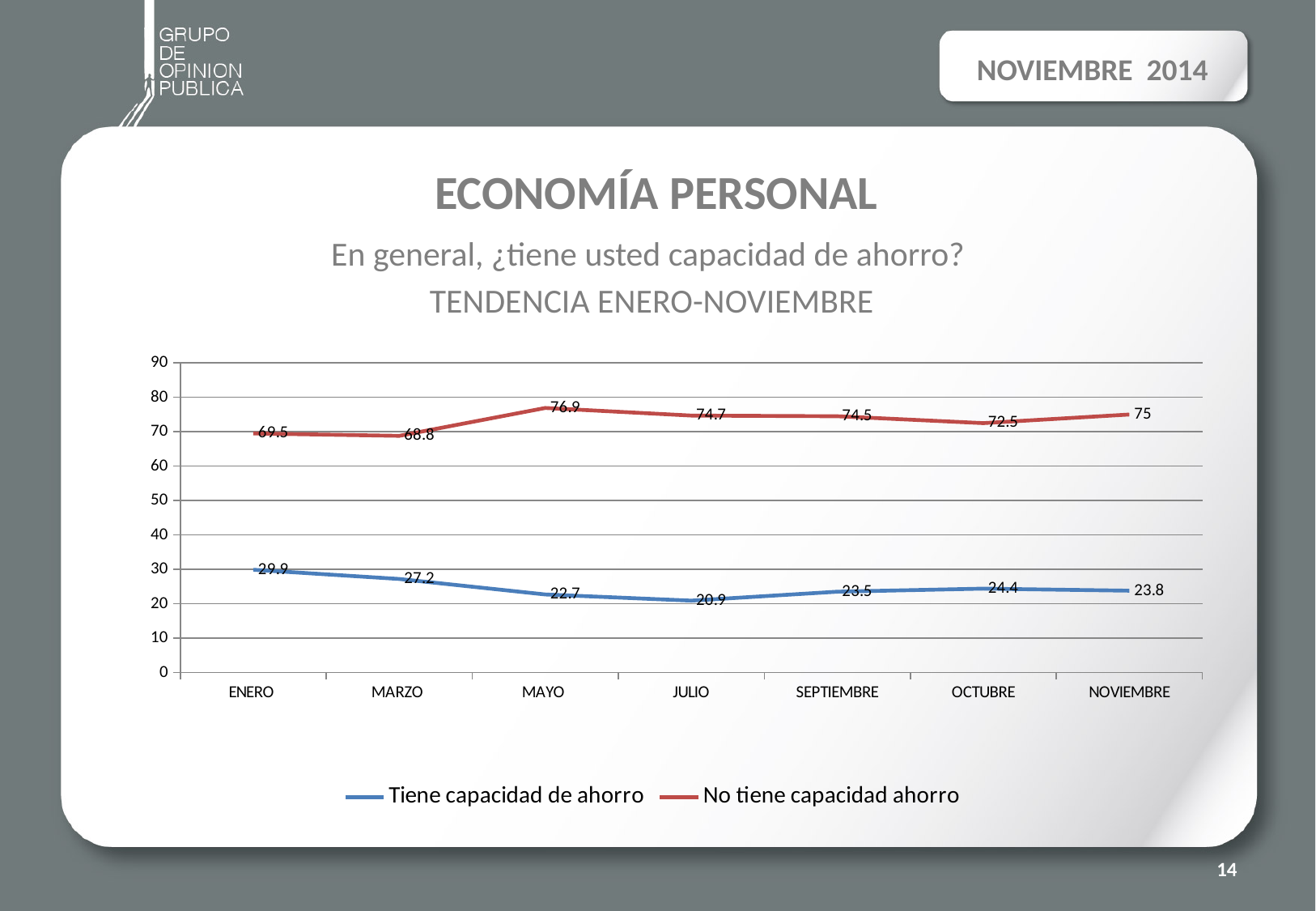
Which is larger for "Tiene capacidad de ahorro": the value in MARZO or the value in OCTUBRE? MARZO How many series does the legend list? 2 In which month is "Tiene capacidad de ahorro" lowest? JULIO What is the value for "Tiene capacidad de ahorro" in ENERO? 29.9 Does "Tiene capacidad de ahorro" rise or fall from ENERO to JULIO? fall What is the value for "Tiene capacidad de ahorro" in NOVIEMBRE? 23.8 What kind of chart is shown on the slide? line chart In which month is "No tiene capacidad ahorro" highest? MAYO What is the value for "No tiene capacidad ahorro" in MAYO? 76.9 What is the difference between "No tiene capacidad ahorro" and "Tiene capacidad de ahorro" in NOVIEMBRE? 51.2 Is the value for "No tiene capacidad ahorro" in ENERO greater or less than 60? greater How many months are shown on the x axis? 7